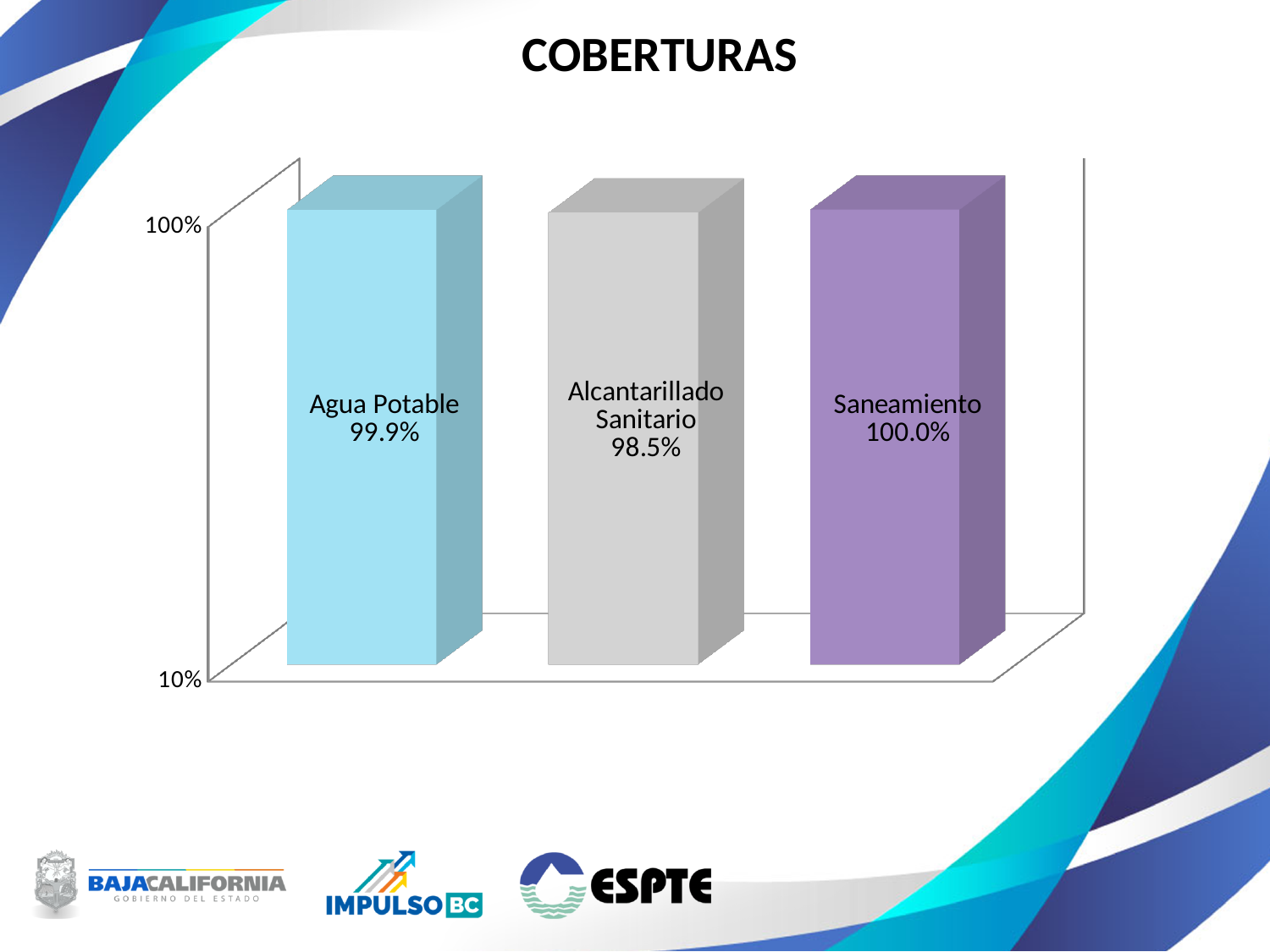
What kind of chart is shown on the slide? Bar chart What is the value for Agua Potable? 99.9% Which is larger, the value for Agua Potable or the value for Alcantarillado Sanitario? Agua Potable What is the value for Alcantarillado Sanitario? 98.5% What is the value for Saneamiento? 100.0% Which category has the lowest value? Alcantarillado Sanitario What is the difference between the values for Saneamiento and Alcantarillado Sanitario? 1.5% How many categories are shown in the chart? 3 What is the difference between the values for Agua Potable and Alcantarillado Sanitario? 1.4% What is the title of the chart? COBERTURAS What colour is the bar for Saneamiento? Purple Which category has the highest value? Saneamiento